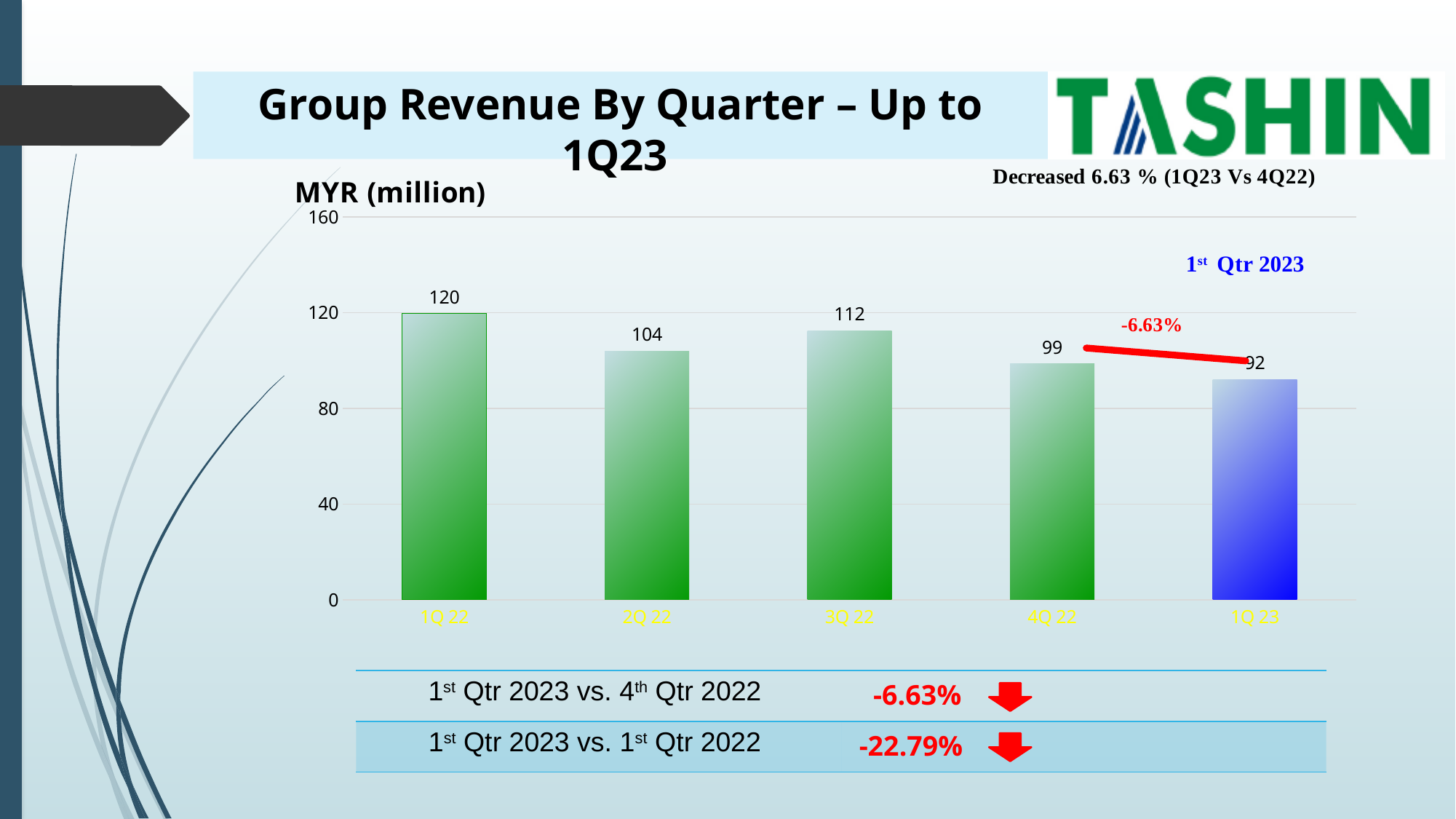
What is the group revenue for 1Q 23? 92 What is the group revenue for 1Q 22? 120 What kind of chart is shown on the slide? bar chart Which quarter has higher revenue, 2Q 22 or 3Q 22? 3Q 22 Is the value for 4Q 22 greater or less than 120? less Which quarter has the highest revenue? 1Q 22 How many quarters are shown in the chart? 5 What is the group revenue for 3Q 22? 112 Which quarter has the lowest revenue? 1Q 23 What unit is shown on the chart's axis label? MYR (million) What is the difference in revenue between 1Q 22 and 2Q 22? 16 What is the difference in revenue between 4Q 22 and 1Q 23? 7